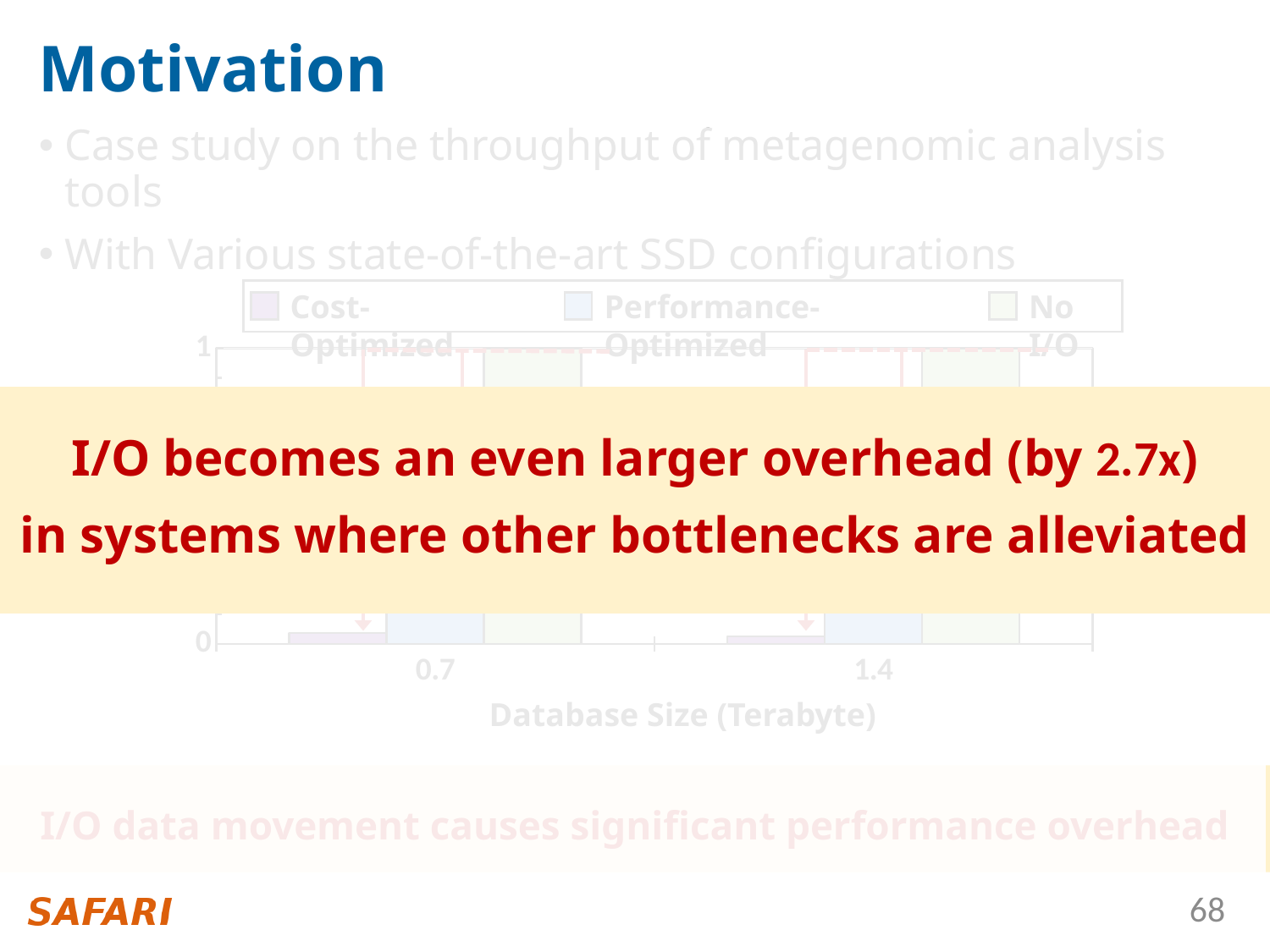
How many series does the chart's legend list? 3 What is the title of the x axis of the chart? Database Size (Terabyte) How many database size categories are shown on the x axis of the chart? 2 What kind of chart is shown on the slide? bar chart Which three series are listed in the chart's legend? Cost-Optimized, Performance-Optimized, No I/O What are the two database sizes labelled on the x axis of the chart? 0.7 and 1.4 Is the value for Cost-Optimized at database size 0.7 greater or less than 1? less